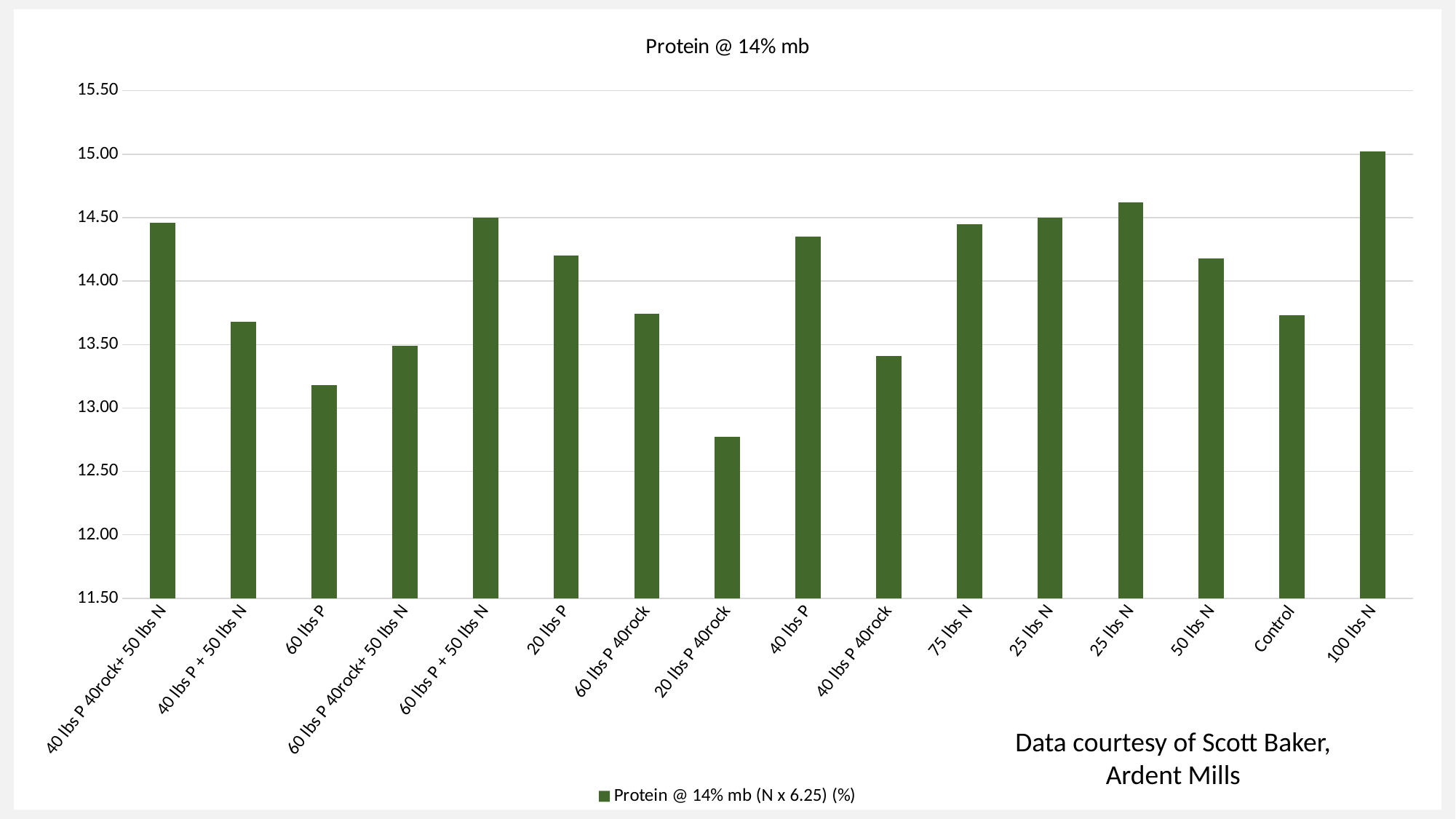
How many categories are plotted on the x axis? 16 Which is larger, the value for 60 lbs P or the value for 40 lbs P + 50 lbs N? 40 lbs P + 50 lbs N Which category has the highest protein value? 100 lbs N What is the title of the chart? Protein @ 14% mb Is the value for 60 lbs P greater or less than 13.50? less How many series does the legend list? 1 What kind of chart is shown on the slide? bar chart Is the value for 20 lbs P 40rock greater or less than 13.00? less Which is larger, the value for Control or the value for 100 lbs N? 100 lbs N Is the value for 100 lbs N greater or less than 14.50? greater Which category has the lowest protein value? 20 lbs P 40rock